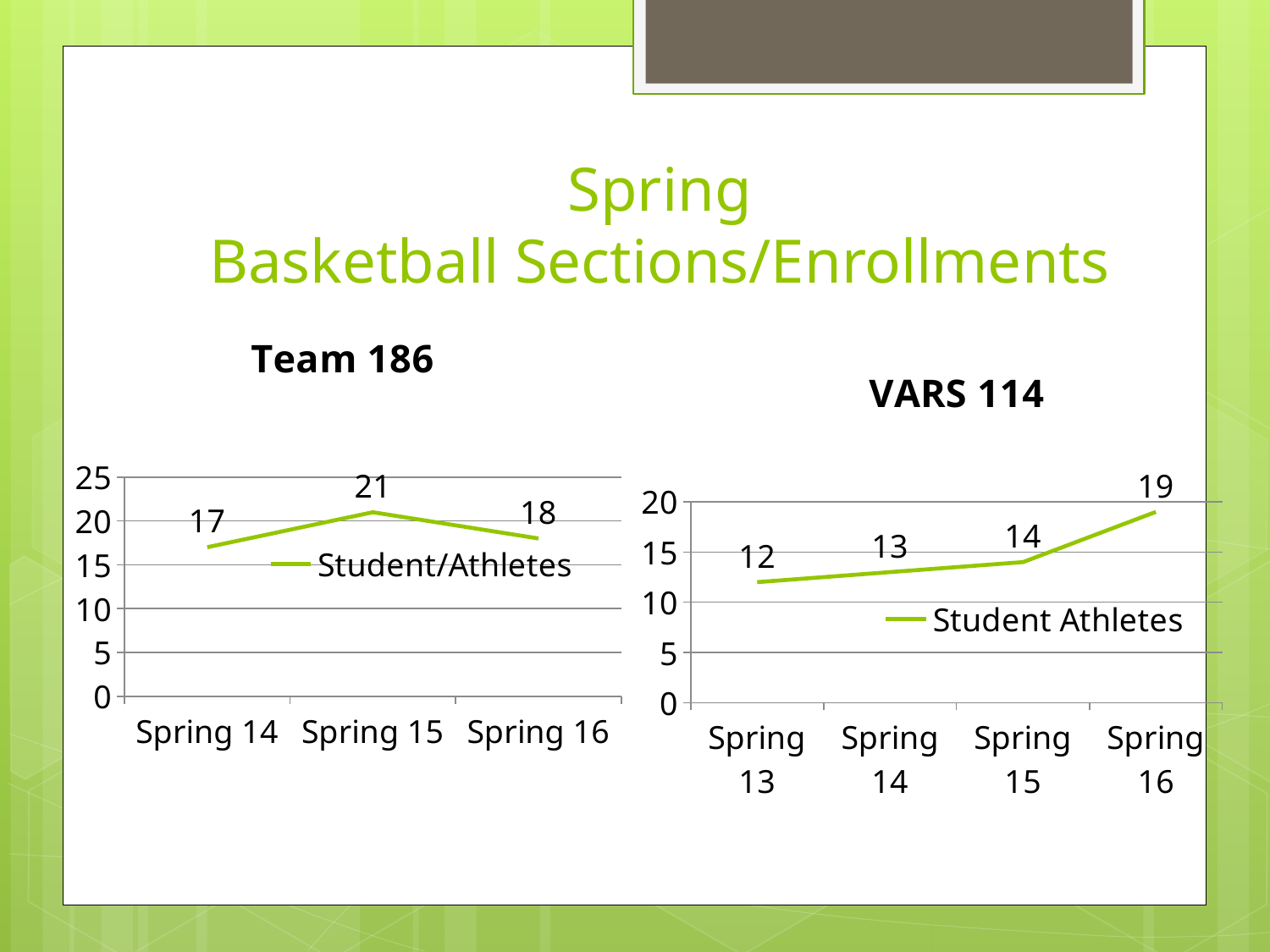
How many data points are plotted in the VARS 114 chart? 4 In the VARS 114 chart, what is the value for Spring 13? 12 In the VARS 114 chart, which is larger, the value for Spring 14 or Spring 16? Spring 16 In the VARS 114 chart, what is the value for Spring 16? 19 In the VARS 114 chart, do the values rise or fall from Spring 13 to Spring 16? Rise In the Team 186 chart, what is the difference between the Spring 15 and Spring 16 values? 3 What kind of chart is the Team 186 chart? Line chart In the Team 186 chart, which term has the highest value? Spring 15 In the Team 186 chart, what is the value for Spring 14? 17 In the VARS 114 chart, what is the difference between the Spring 16 and Spring 15 values? 5 In the VARS 114 chart, which term has the lowest value? Spring 13 In the Team 186 chart, what is the value for Spring 15? 21